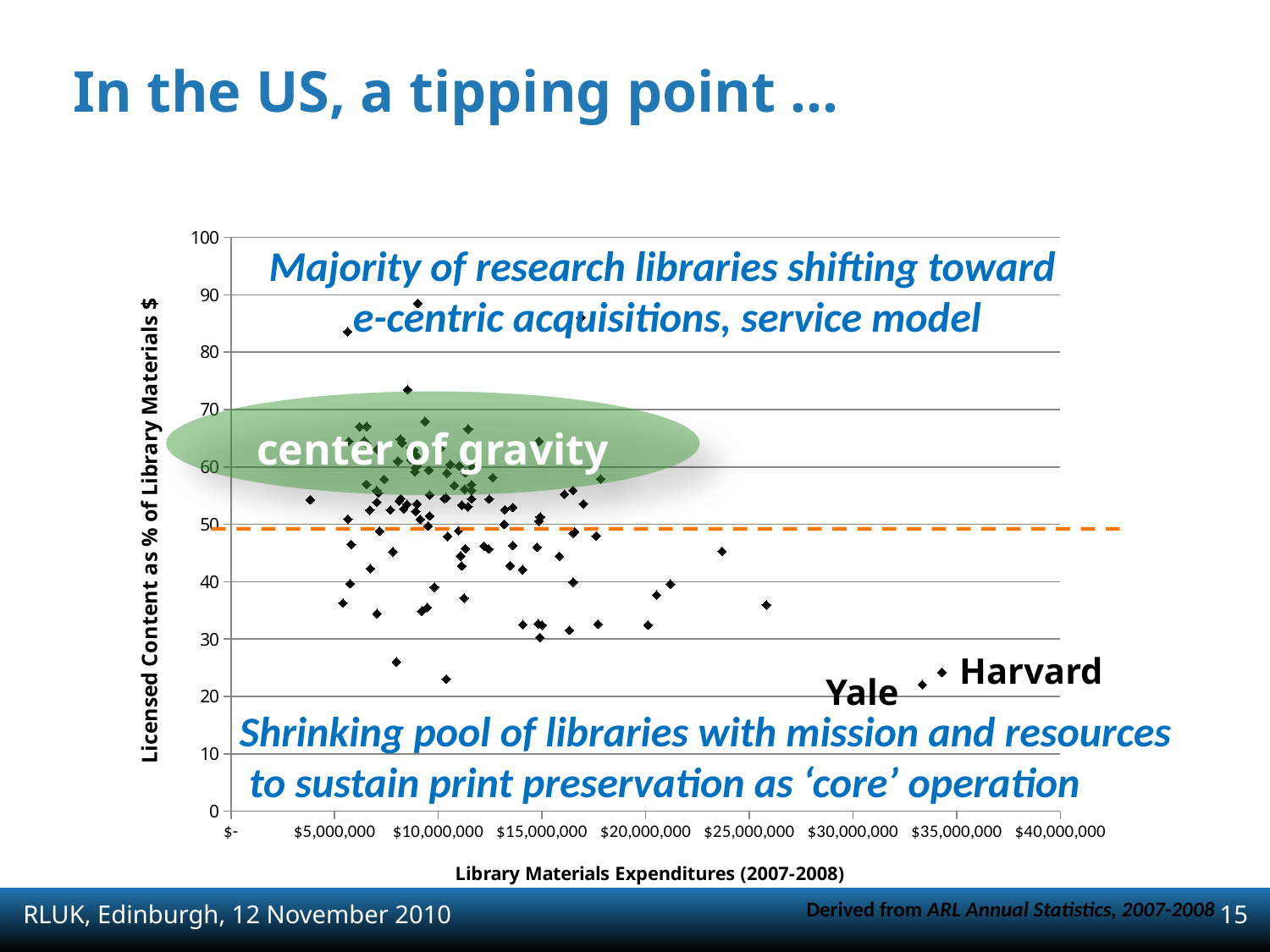
Is the licensed content percentage for Harvard greater or less than 30? less What is the highest value shown on the y axis? 100 Is the licensed content percentage for Harvard greater or less than 20? greater Is the library materials expenditure for Harvard greater or less than $30,000,000? greater What is the highest tick label shown on the x axis? $40,000,000 What is the title of the x axis? Library Materials Expenditures (2007-2008) What is the title of the y axis? Licensed Content as % of Library Materials $ What kind of chart is shown on the slide? scatter chart At what value on the y axis is the orange dashed horizontal line drawn? 50